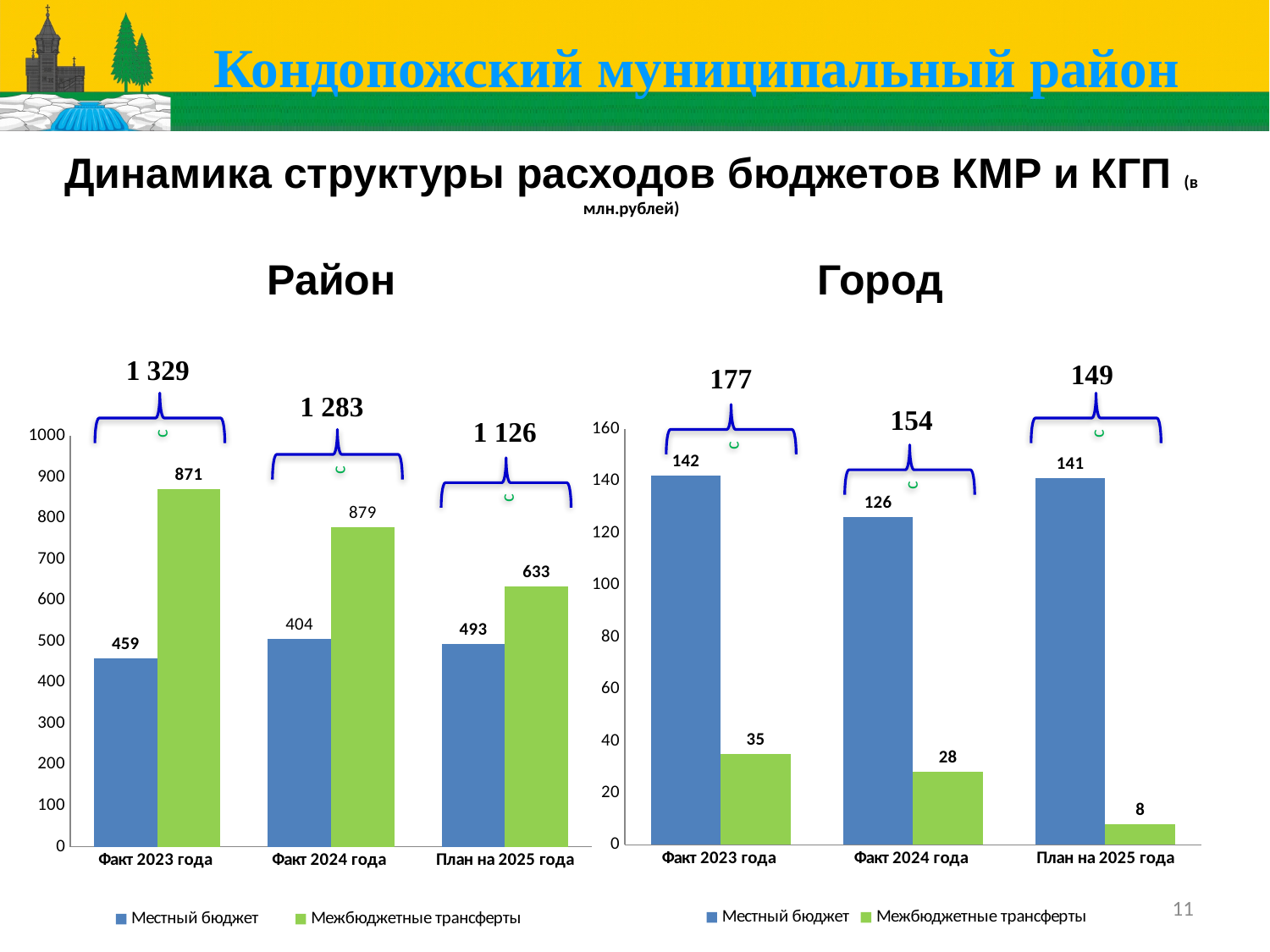
In the Город chart, what is the difference between Местный бюджет and Межбюджетные трансферты for Факт 2023 года? 107 What kind of chart is the Город chart? Bar chart In the Район chart, what is the value of Местный бюджет for Факт 2023 года? 459 In the Город chart, which category has the lowest value for Межбюджетные трансферты? План на 2025 года In the Район chart, what total is printed above the bracket for План на 2025 года? 1 126 In the Город chart, what is the value of Местный бюджет for Факт 2024 года? 126 In the Район chart, what is the value of Межбюджетные трансферты for План на 2025 года? 633 How many series does the legend of the Район chart list? 2 In the Город chart, do the values for Межбюджетные трансферты rise or fall from Факт 2023 года to План на 2025 года? Fall In the Город chart, what is the value of Межбюджетные трансферты for План на 2025 года? 8 In the Город chart, which is larger: Межбюджетные трансферты for Факт 2023 года or for Факт 2024 года? Факт 2023 года